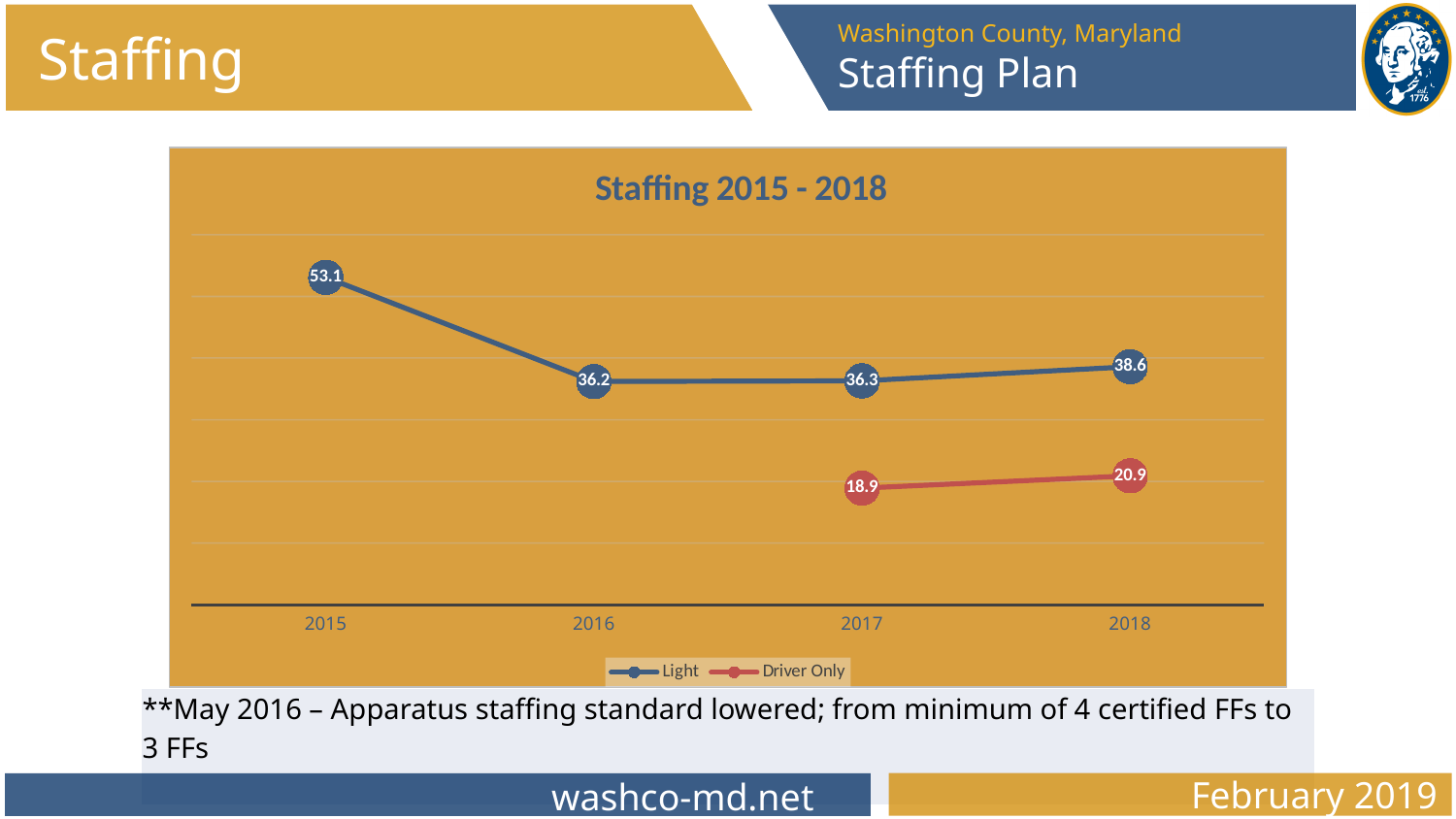
What is the value for Driver Only in 2017? 18.9 What is the difference between the Light and Driver Only values in 2018? 17.7 What is the value for Driver Only in 2018? 20.9 What is the difference between the Light values for 2015 and 2016? 16.9 How many series does the legend list? 2 In which year is the Light series lowest? 2016 What is the value for Light in 2018? 38.6 How many years are shown on the x axis? 4 What kind of chart is this? Line chart What is the value for Light in 2015? 53.1 Which is larger in 2017, the Light value or the Driver Only value? Light In which year is the Light series highest? 2015